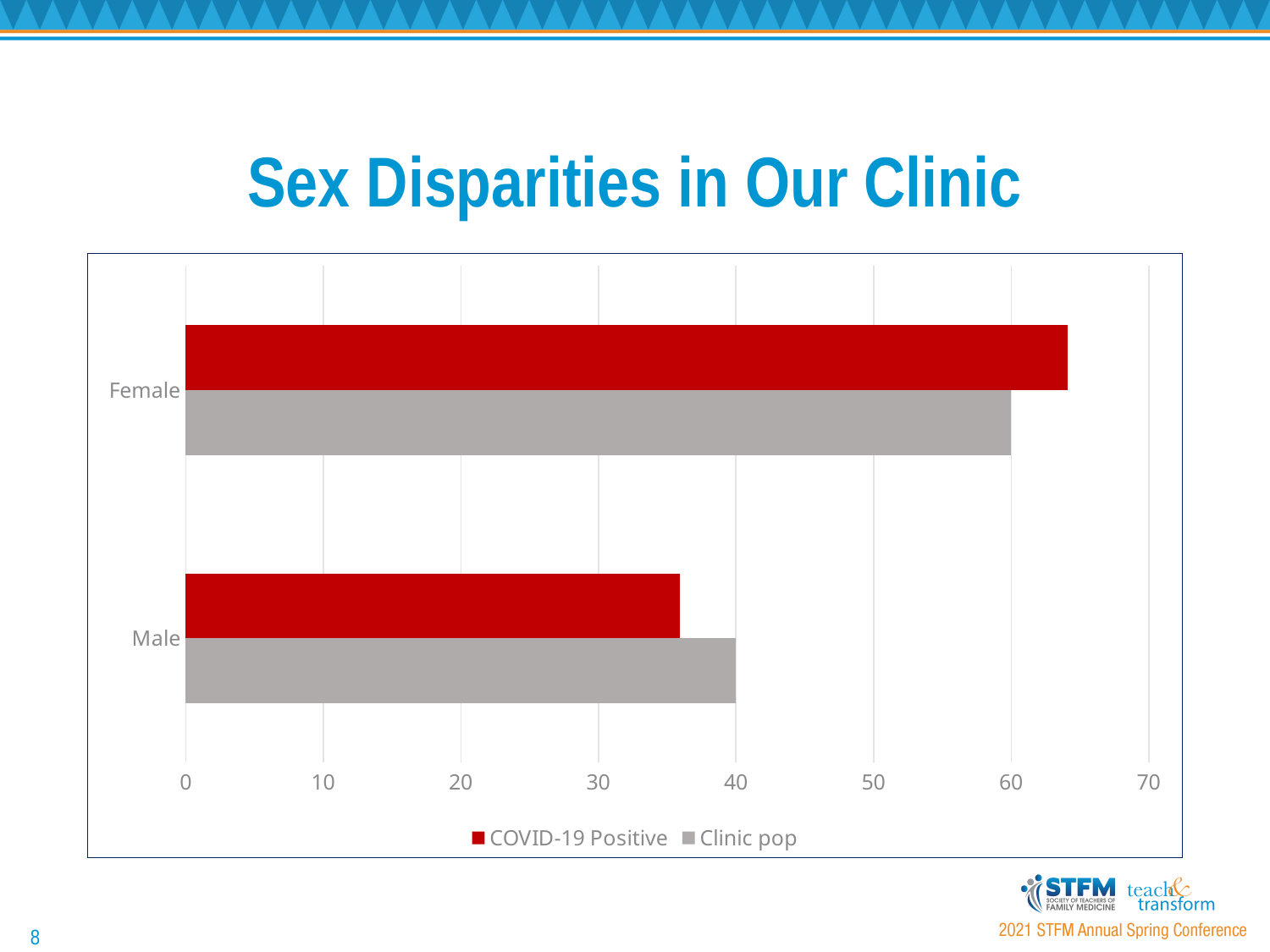
Is the COVID-19 Positive value for Female greater or less than 60? greater How many series does the legend list? 2 Is the COVID-19 Positive value for Male greater or less than 40? less How many categories are shown on the vertical axis? 2 What is the difference between the Clinic pop values for Female and Male? 20 What is the Clinic pop value for Male? 40 Which category has the lowest Clinic pop value? Male What colour are the COVID-19 Positive bars? red For Female, which is larger: COVID-19 Positive or Clinic pop? COVID-19 Positive What is the Clinic pop value for Female? 60 What kind of chart is shown on the slide? bar chart Which category has the highest COVID-19 Positive value? Female